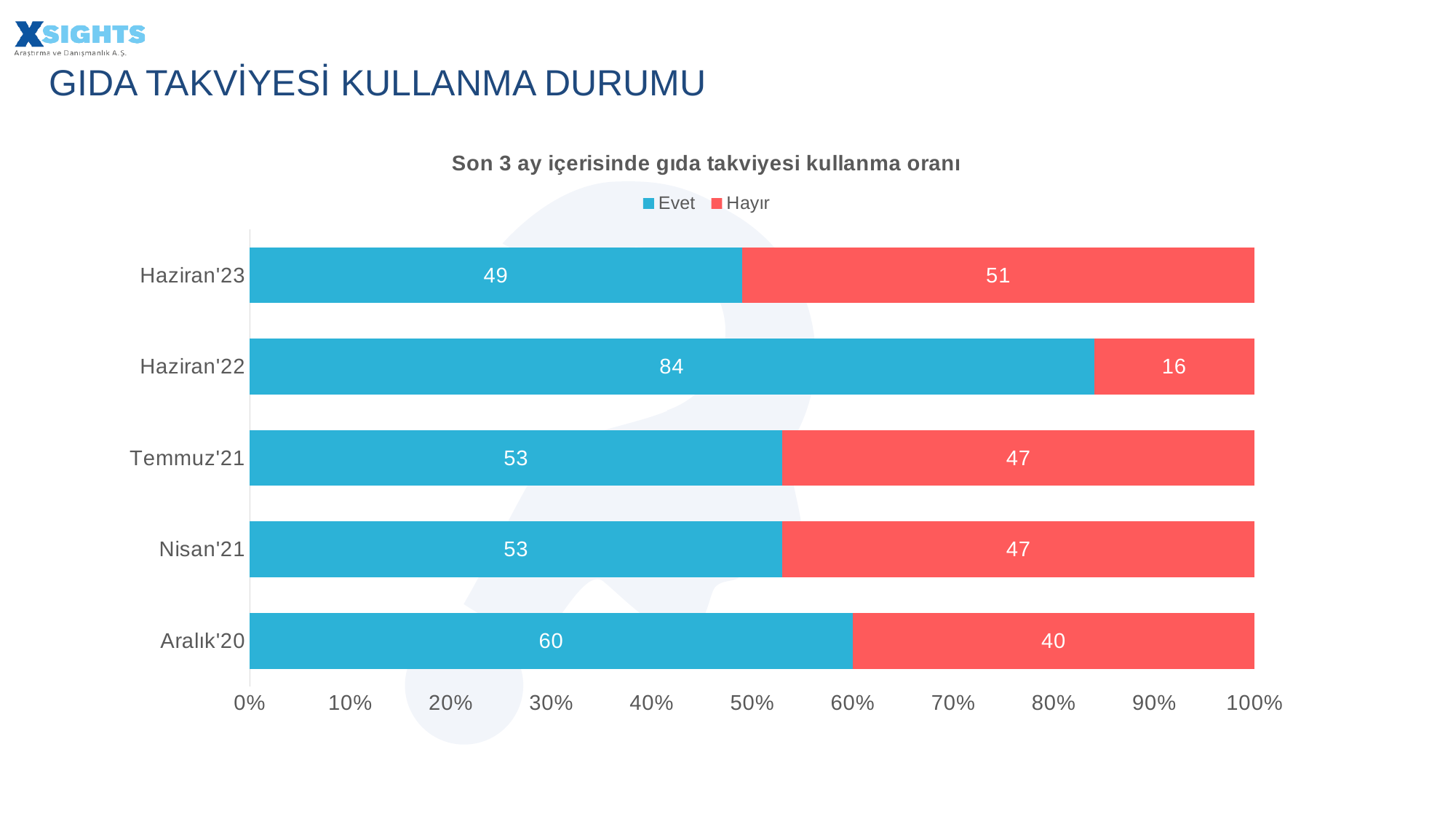
What is the Evet value for Haziran'22? 84 Which period has the lowest Hayır value? Haziran'22 What is the difference between the Evet values for Haziran'22 and Haziran'23? 35 What is the Evet value for Haziran'23? 49 What kind of chart is shown on the slide? Stacked bar chart Which period has the highest Evet value? Haziran'22 How many periods are shown on the chart? 5 Which is larger for Haziran'23, the Evet value or the Hayır value? Hayır How many series does the legend list? 2 What is the title of the chart? Son 3 ay içerisinde gıda takviyesi kullanma oranı What is the Hayır value for Aralık'20? 40 What is the total of the stacked bar for Temmuz'21? 100